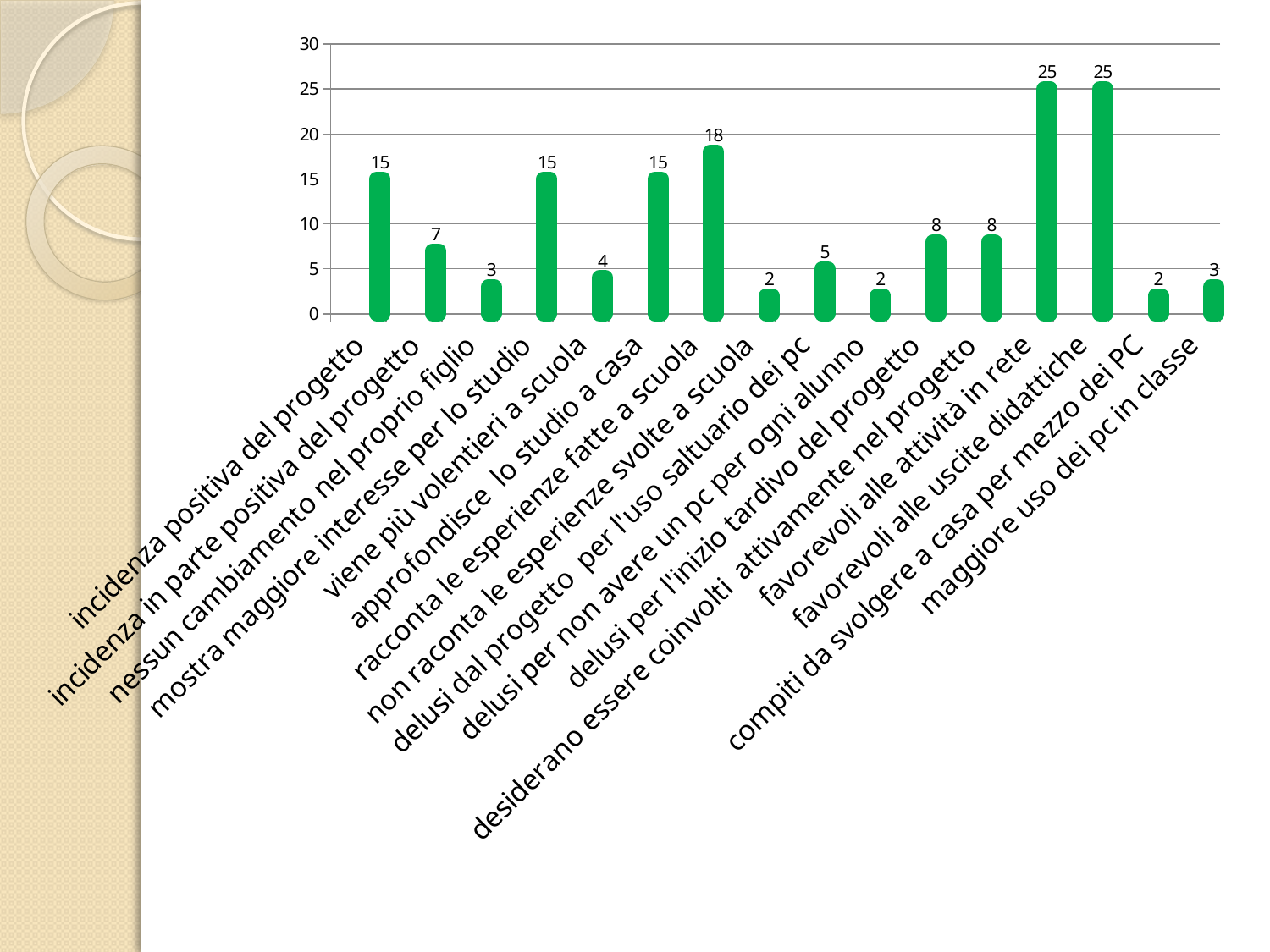
What kind of chart is shown on the slide? bar chart What is the value for "favorevoli alle uscite didattiche"? 25 What is the value for "racconta le esperienze fatte a scuola"? 18 What is the difference between the values for "incidenza positiva del progetto" and "nessun cambiamento nel proprio figlio"? 12 What is the difference between the values for "favorevoli alle attività in rete" and "racconta le esperienze fatte a scuola"? 7 How many categories are shown in the chart? 16 Is the value for "approfondisce lo studio a casa" greater or less than 10? greater Which is larger, the value for "viene più volentieri a scuola" or the value for "delusi per l'inizio tardivo del progetto"? delusi per l'inizio tardivo del progetto What is the lowest value shown in the chart? 2 What is the value for "delusi dal progetto per l'uso saltuario dei pc"? 5 What is the value for "incidenza in parte positiva del progetto"? 7 What is the highest value shown in the chart? 25